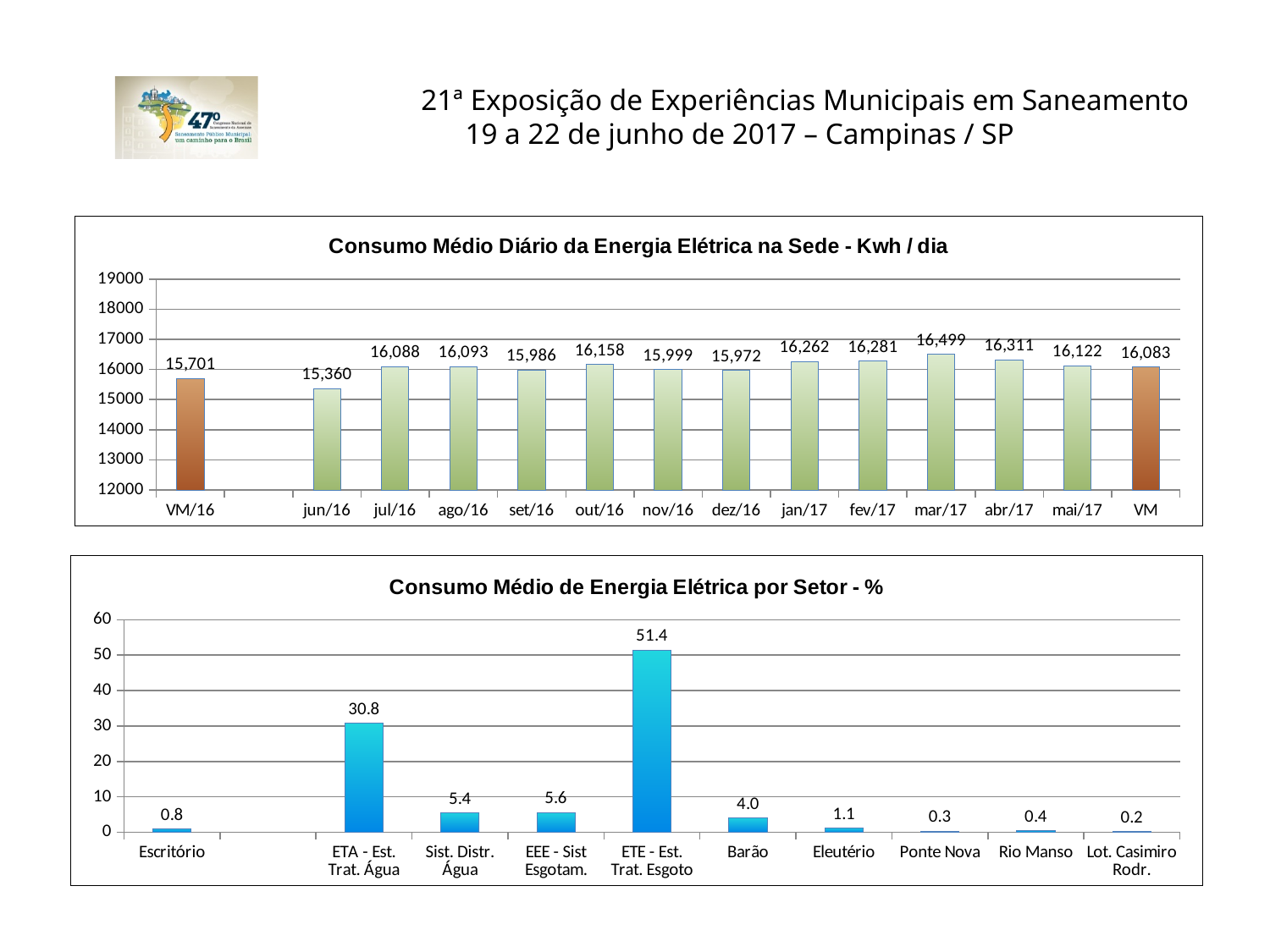
What type of chart is the bottom chart (Consumo Médio de Energia Elétrica por Setor)? Bar chart In the top chart (Consumo Médio Diário da Energia Elétrica na Sede), what is the value for mar/17? 16,499 In the bottom chart (Consumo Médio de Energia Elétrica por Setor), what is the value for ETE - Est. Trat. Esgoto? 51.4 In the top chart (Consumo Médio Diário da Energia Elétrica na Sede), which month has the highest value? mar/17 In the top chart (Consumo Médio Diário da Energia Elétrica na Sede), how many bars are plotted? 14 In the bottom chart (Consumo Médio de Energia Elétrica por Setor), which is larger, Sist. Distr. Água or EEE - Sist Esgotam.? EEE - Sist Esgotam. In the top chart (Consumo Médio Diário da Energia Elétrica na Sede), is the value for jun/16 greater or less than 16000? less In the top chart (Consumo Médio Diário da Energia Elétrica na Sede), what is the value for VM/16? 15,701 In the bottom chart (Consumo Médio de Energia Elétrica por Setor), which sector has the lowest value? Lot. Casimiro Rodr. In the bottom chart (Consumo Médio de Energia Elétrica por Setor), what is the difference between ETE - Est. Trat. Esgoto and ETA - Est. Trat. Água? 20.6 In the top chart (Consumo Médio Diário da Energia Elétrica na Sede), what is the difference between the VM value and the VM/16 value? 382 In the top chart (Consumo Médio Diário da Energia Elétrica na Sede), which month has the lowest value? jun/16